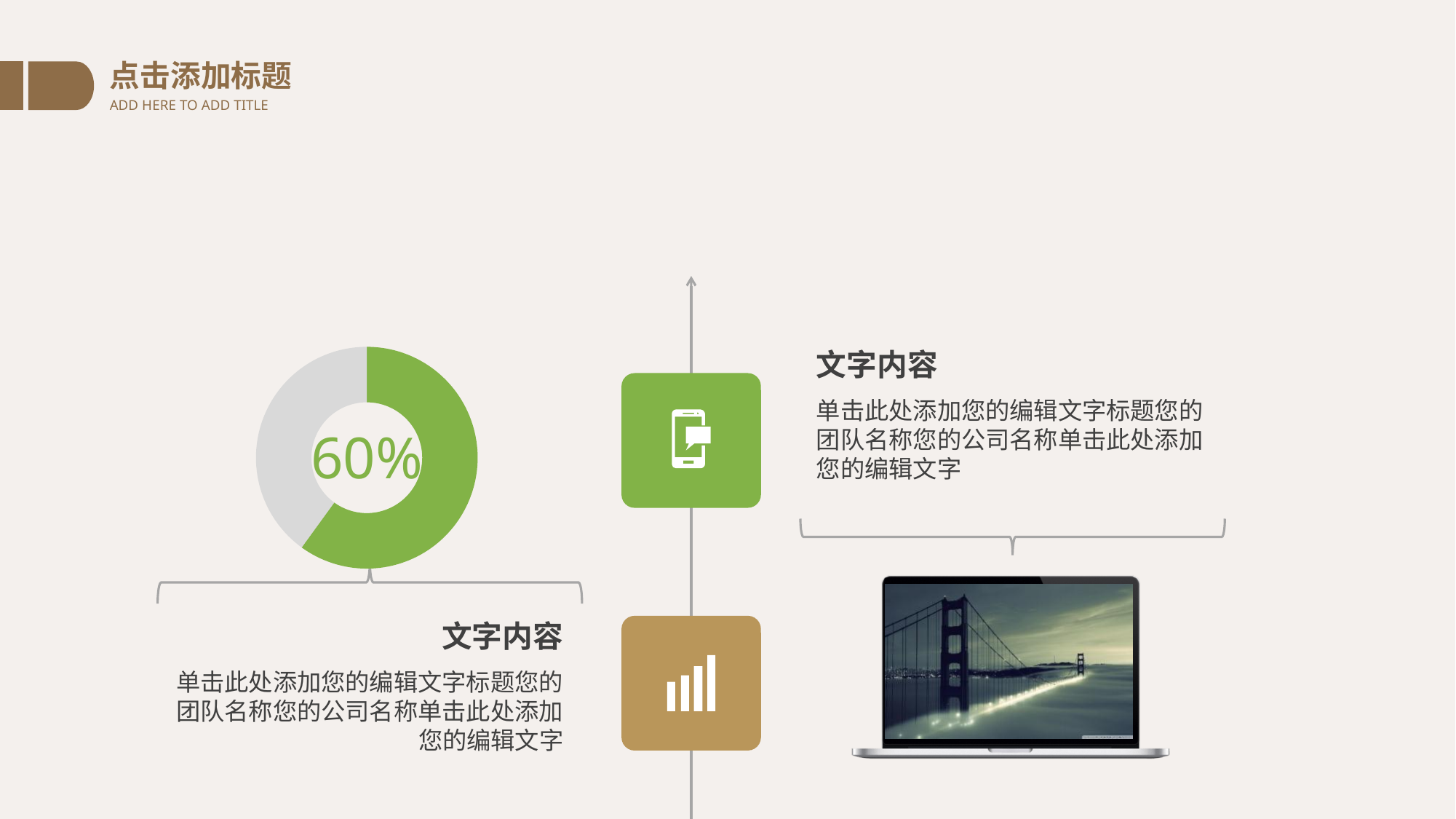
What kind of chart is shown on the left of the slide? Donut chart What percentage is printed in the centre of the donut chart? 60% What share of the donut chart is filled in green? 60% What colour is the larger segment of the donut chart? Green What colour is the smaller segment of the donut chart? Grey Is the green segment of the donut chart greater or less than 50%? greater Which segment of the donut chart is larger, the green one or the grey one? The green one How many segments does the donut chart have? 2